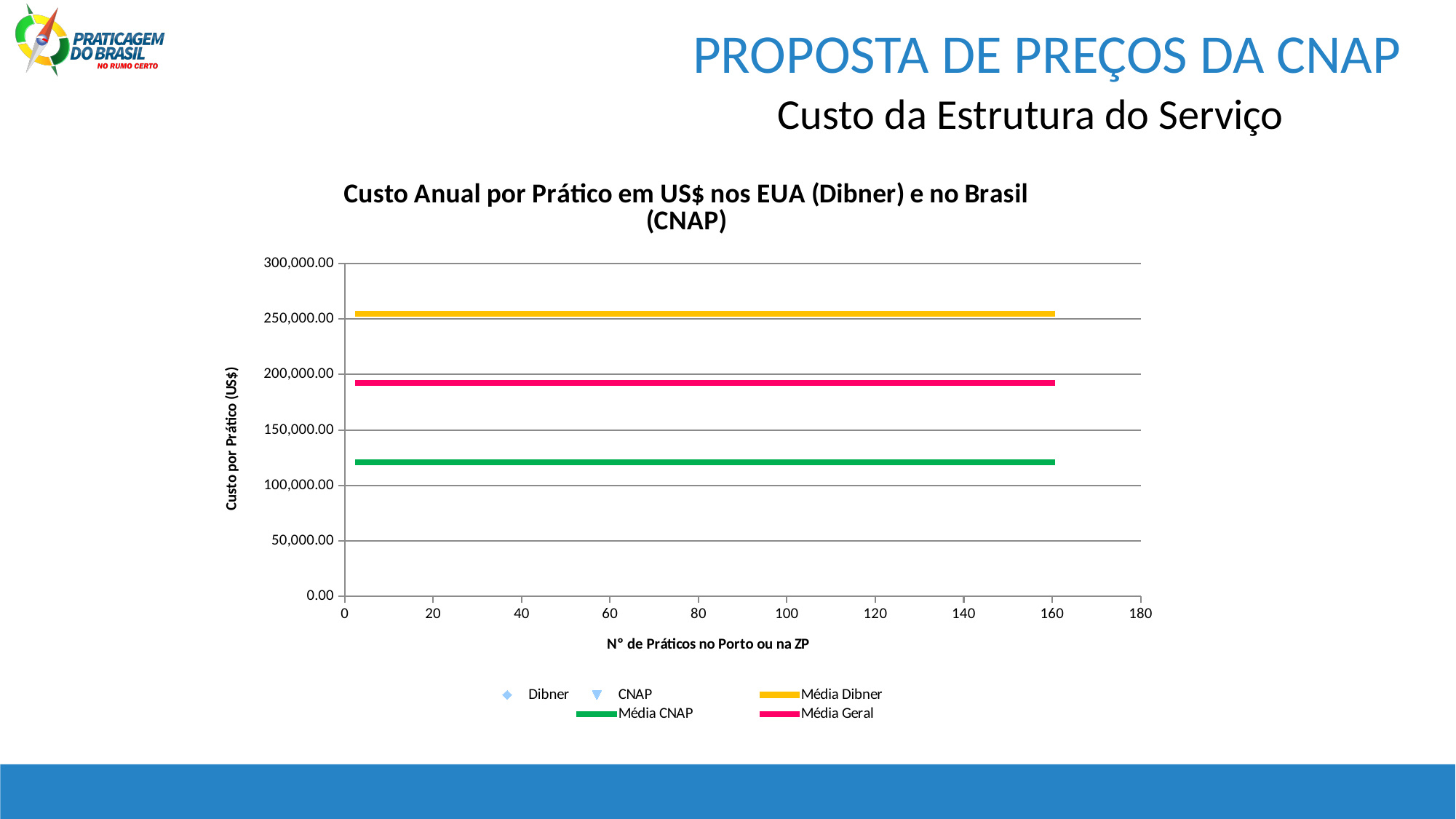
Does the Média Dibner line rise, fall, or stay flat as the number of práticos increases along the x axis? stays flat Which of the plotted average lines is the highest? Média Dibner Which of the plotted average lines is the lowest? Média CNAP How many series does the chart legend list? 5 Is the value of the Média CNAP line greater or less than 150,000.00? less What is the title of the chart? Custo Anual por Prático em US$ nos EUA (Dibner) e no Brasil (CNAP) What is the label of the x axis of the chart? N° de Práticos no Porto ou na ZP Is the value of the Média Geral line greater or less than 150,000.00? greater Is the value of the Média Dibner line greater or less than 250,000.00? greater What kind of chart is shown on the slide? line chart Which is larger, the Média Geral line or the Média CNAP line? Média Geral